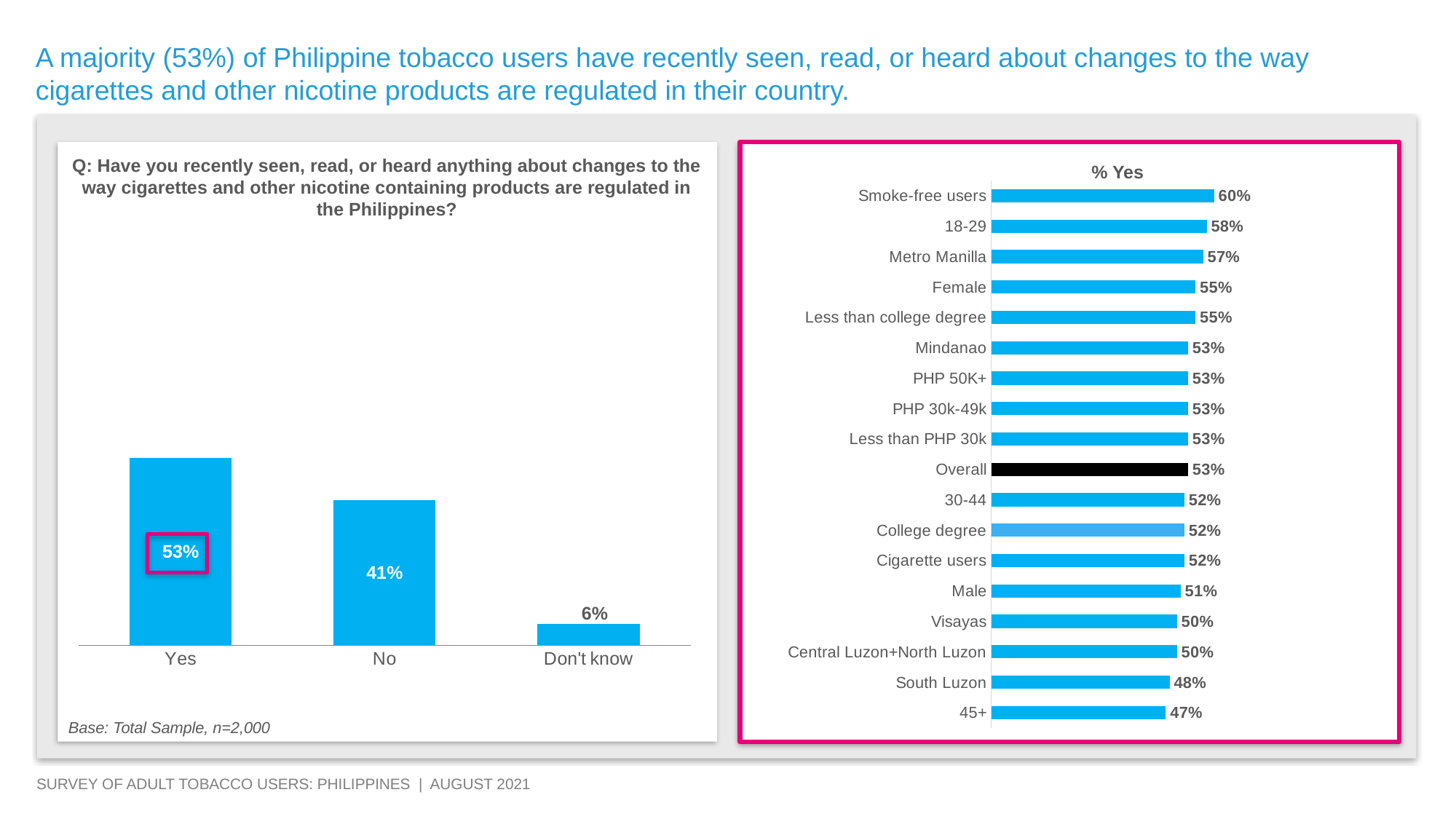
In the '% Yes' chart, what is the difference between the values for 18-29 and 45+? 11% In the '% Yes' chart, which group has the highest value? Smoke-free users In the '% Yes' chart, what is the value for South Luzon? 48% In the left chart, what is the difference between the 'Yes' and 'No' percentages? 12% In the left chart, what percentage of respondents answered 'Don't know'? 6% In the '% Yes' chart, which group has the lowest value? 45+ In the '% Yes' chart, which is larger: the value for Female or the value for Male? Female In the left chart, what percentage of respondents answered 'Yes'? 53% In the '% Yes' chart, how many groups are listed? 18 In the '% Yes' chart, what is the value for Metro Manilla? 57% What kind of chart is the left chart? Bar chart In the left chart, how many response categories are shown? 3